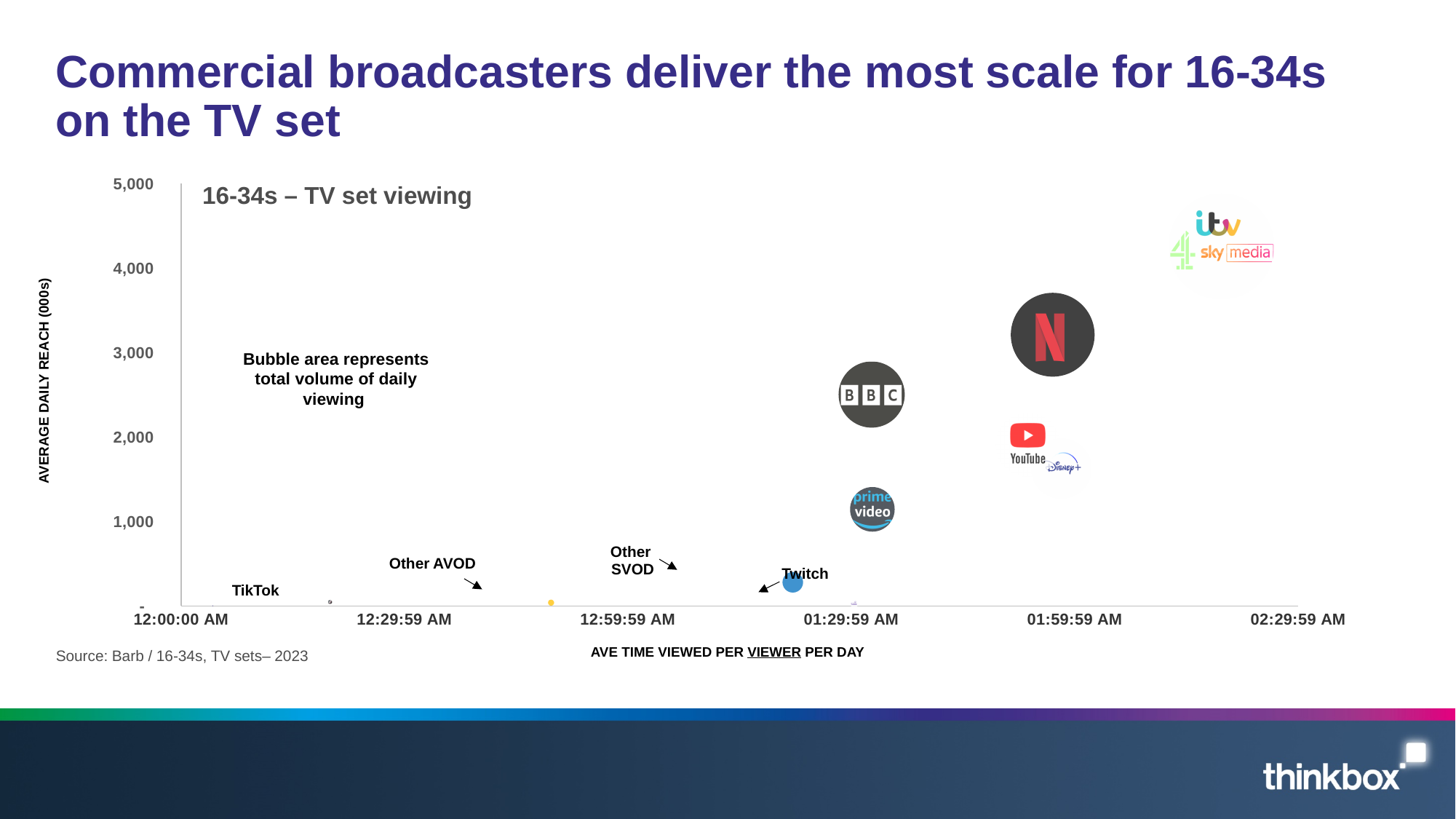
Is the average daily reach for Netflix greater or less than 3,000? greater Is the average daily reach for Prime Video greater or less than 2,000? less Is the average daily reach for BBC greater or less than 2,000? greater Which has the higher average daily reach, Netflix or BBC? Netflix What is the title of the chart? 16-34s – TV set viewing What does the bubble area represent in the chart? Total volume of daily viewing Which bubble has the highest average daily reach? Commercial broadcasters (ITV, Channel 4, Sky Media) Which has the higher average daily reach, Prime Video or Twitch? Prime Video What kind of chart is shown on the slide? Bubble chart